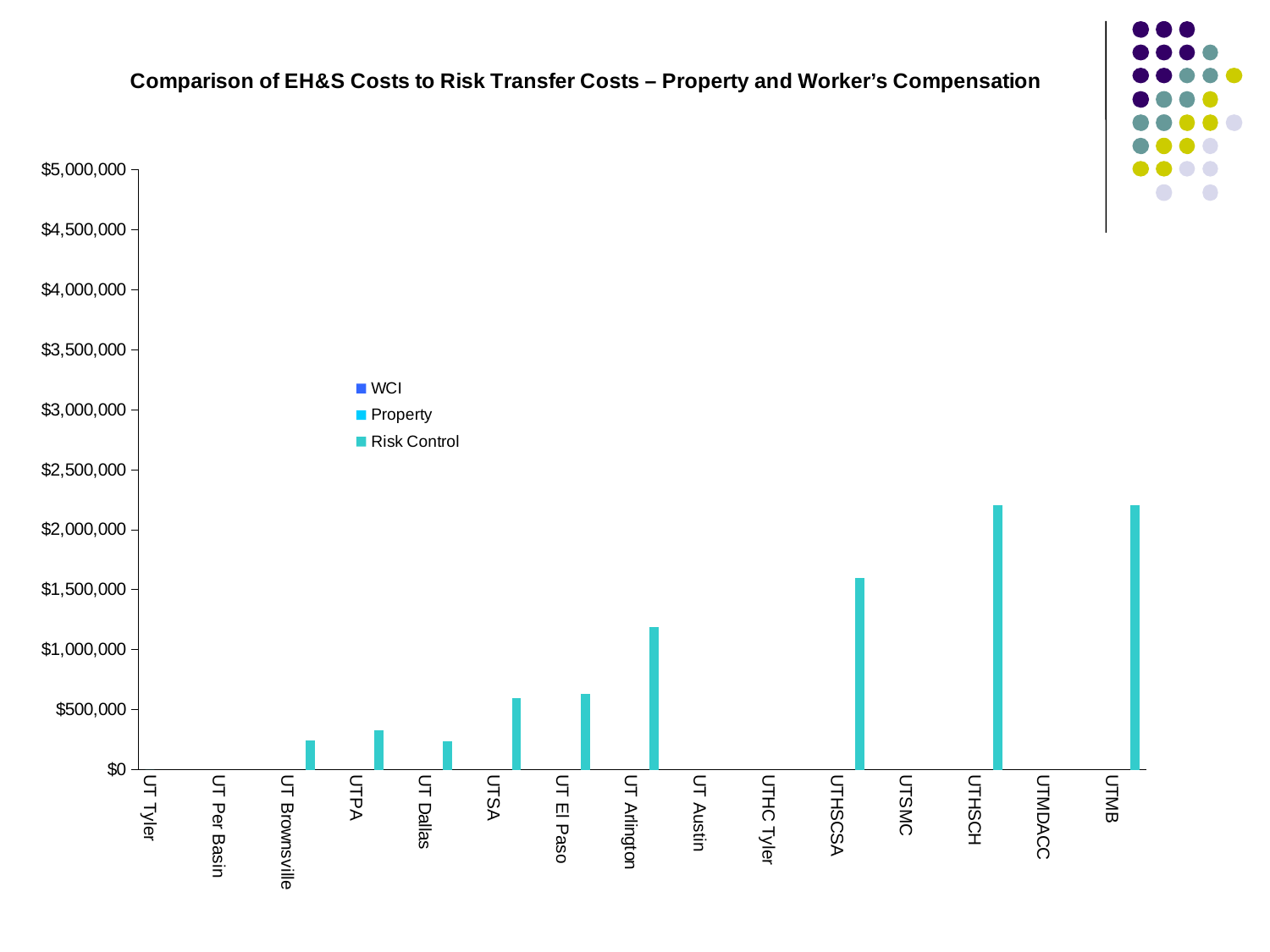
What is the title of the chart? Comparison of EH&S Costs to Risk Transfer Costs – Property and Worker's Compensation What kind of chart is shown on the slide? bar chart Which series are listed in the legend? WCI, Property, Risk Control Which has the larger Risk Control value, UT Arlington or UTSA? UT Arlington Which has the larger Risk Control value, UTHSCSA or UT El Paso? UTHSCSA Is the Risk Control value for UTMB greater or less than $2,000,000? greater Is the Risk Control value for UTHSCH greater or less than $2,000,000? greater Is the Risk Control value for UT Arlington greater or less than $1,000,000? greater How many series does the legend list? 3 How many institutions are shown along the x axis? 15